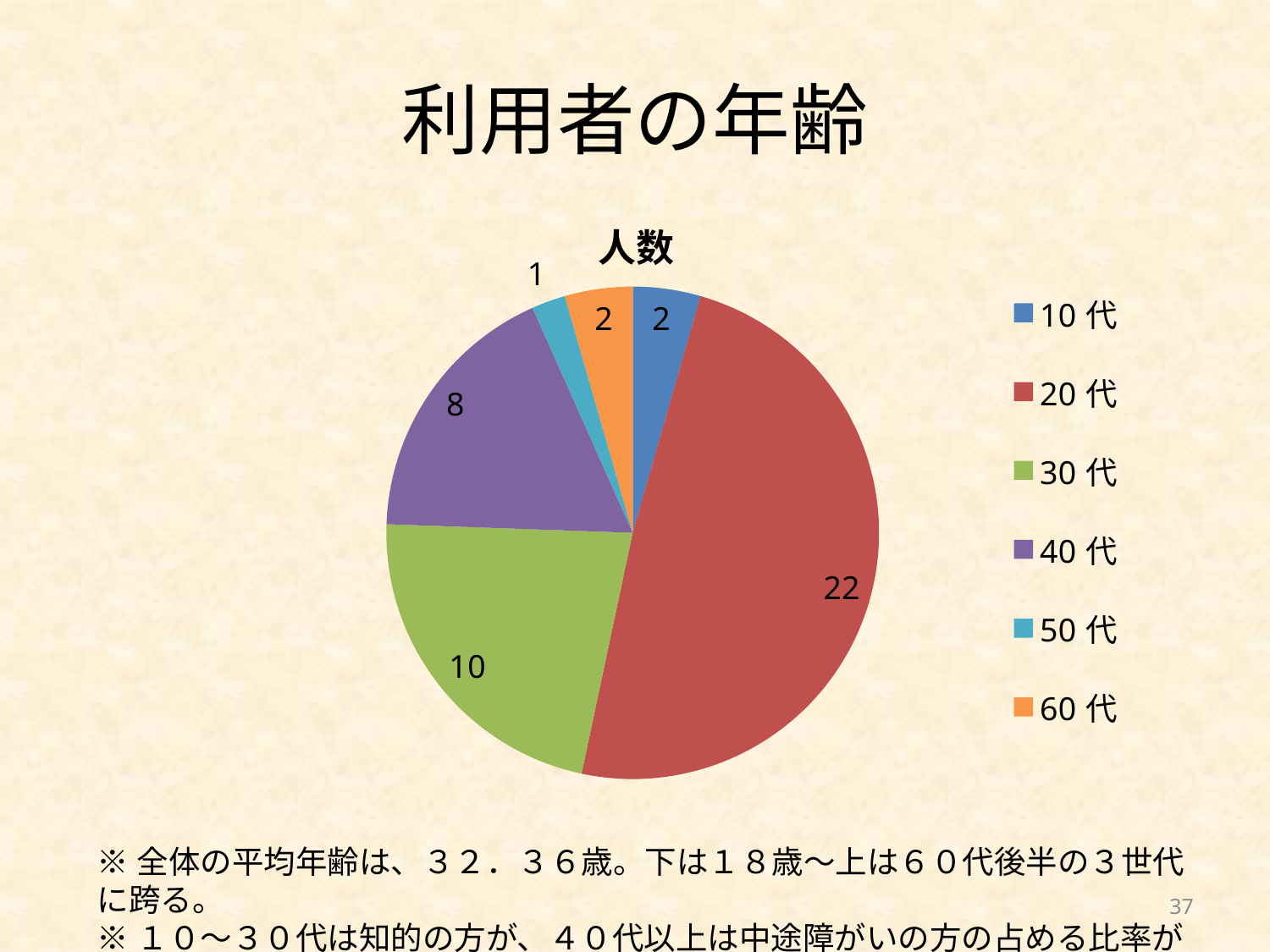
What type of chart is shown on the slide? pie chart What is the title of the pie chart? 人数 What is the value for 50代 in the 人数 pie chart? 1 What is the value for 40代 in the 人数 pie chart? 8 What is the total of all the values in the pie chart? 45 What is the value for 30代 in the 人数 pie chart? 10 What is the value for 20代 in the 人数 pie chart? 22 Which is larger, the value for 40代 or the value for 60代? 40代 Which age group has the smallest slice in the pie chart? 50代 Which age group has the largest slice in the pie chart? 20代 What is the difference between the values for 20代 and 30代? 12 How many age groups does the legend list? 6